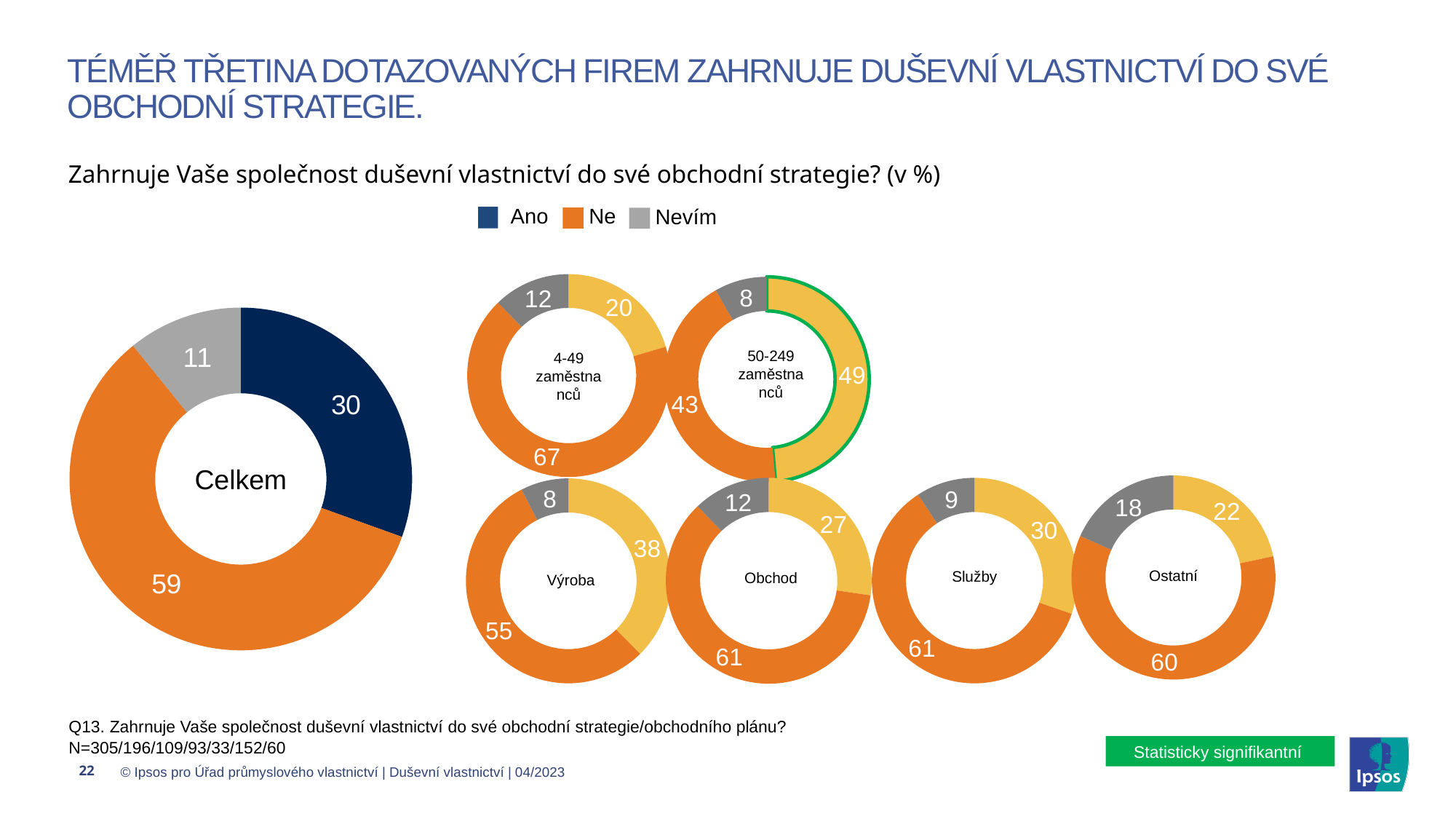
In the 4-49 zaměstnanců donut chart, what is the value of the grey (Nevím) segment? 12 Which is larger: the orange (Ne) segment in the Obchod donut chart or the orange (Ne) segment in the Výroba donut chart? Obchod In the Celkem donut chart, what is the value for Ne? 59 In the Celkem donut chart, what is the difference between the Ne and Ano values? 29 How many series does the legend list? 3 In the Výroba donut chart, what is the value of the orange (Ne) segment? 55 In the Ostatní donut chart, what is the value of the grey (Nevím) segment? 18 What kind of chart is the Celkem chart? Donut chart In the 50-249 zaměstnanců donut chart, what is the value of the orange (Ne) segment? 43 In the Celkem donut chart, what is the value for Nevím? 11 In the Celkem donut chart, what is the value for Ano? 30 In the Celkem donut chart, which category has the largest share? Ne